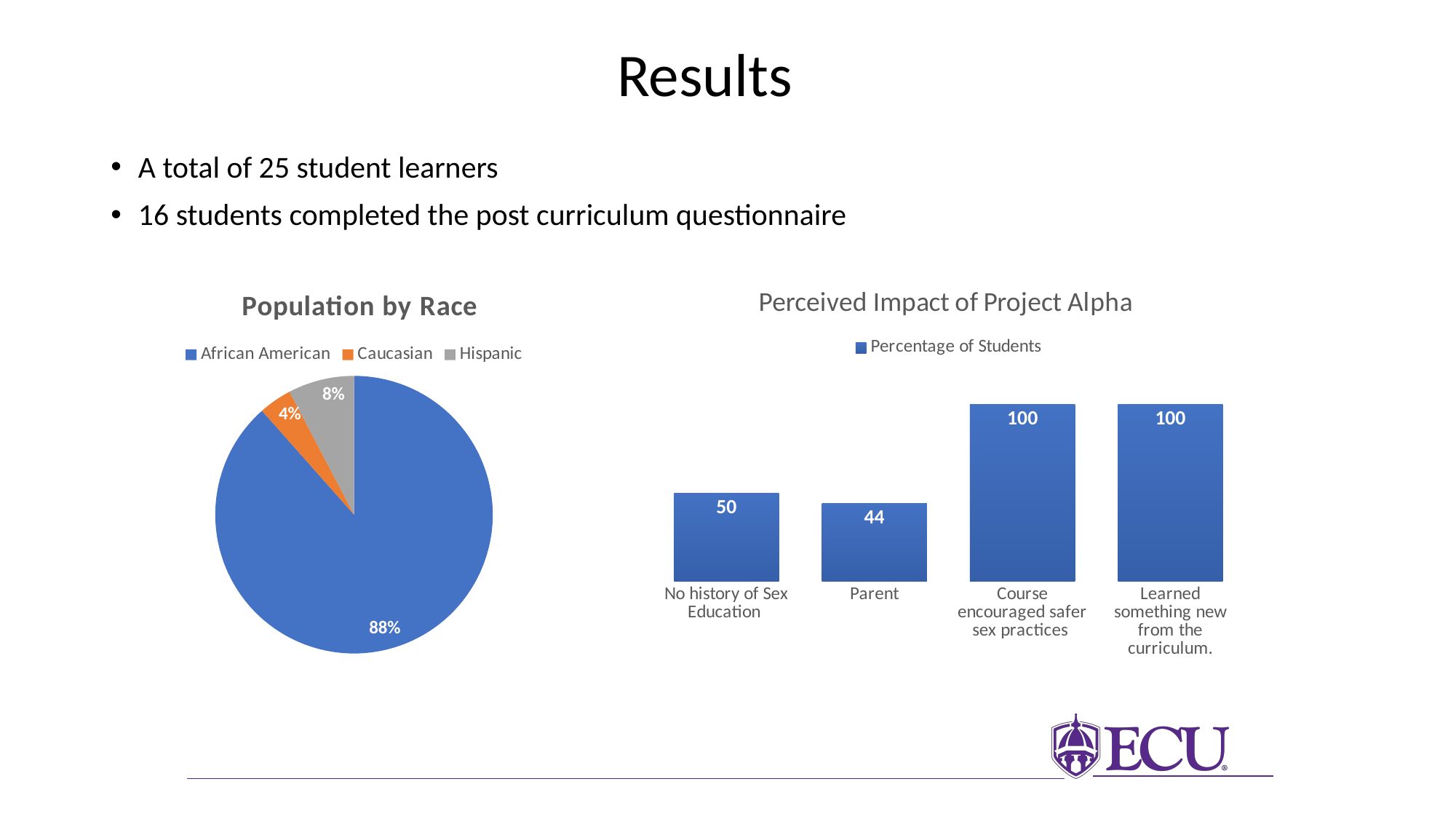
In the 'Population by Race' chart, what share of the pie is African American? 88% In the 'Perceived Impact of Project Alpha' chart, what is the value for 'No history of Sex Education'? 50 In the 'Population by Race' chart, which race has the smallest slice? Caucasian In the 'Population by Race' chart, how many slices does the pie have? 3 In the 'Population by Race' chart, what share of the pie is Caucasian? 4% In the 'Perceived Impact of Project Alpha' chart, which category has the lowest value? Parent In the 'Perceived Impact of Project Alpha' chart, what is the value for Parent? 44 What kind of chart is 'Population by Race'? Pie chart In the 'Perceived Impact of Project Alpha' chart, what is the difference between the value for 'Learned something new from the curriculum.' and the value for Parent? 56 In the 'Perceived Impact of Project Alpha' chart, what is the value for 'Course encouraged safer sex practices'? 100 In the 'Population by Race' chart, what share of the pie is Hispanic? 8% What kind of chart is 'Perceived Impact of Project Alpha'? Bar chart